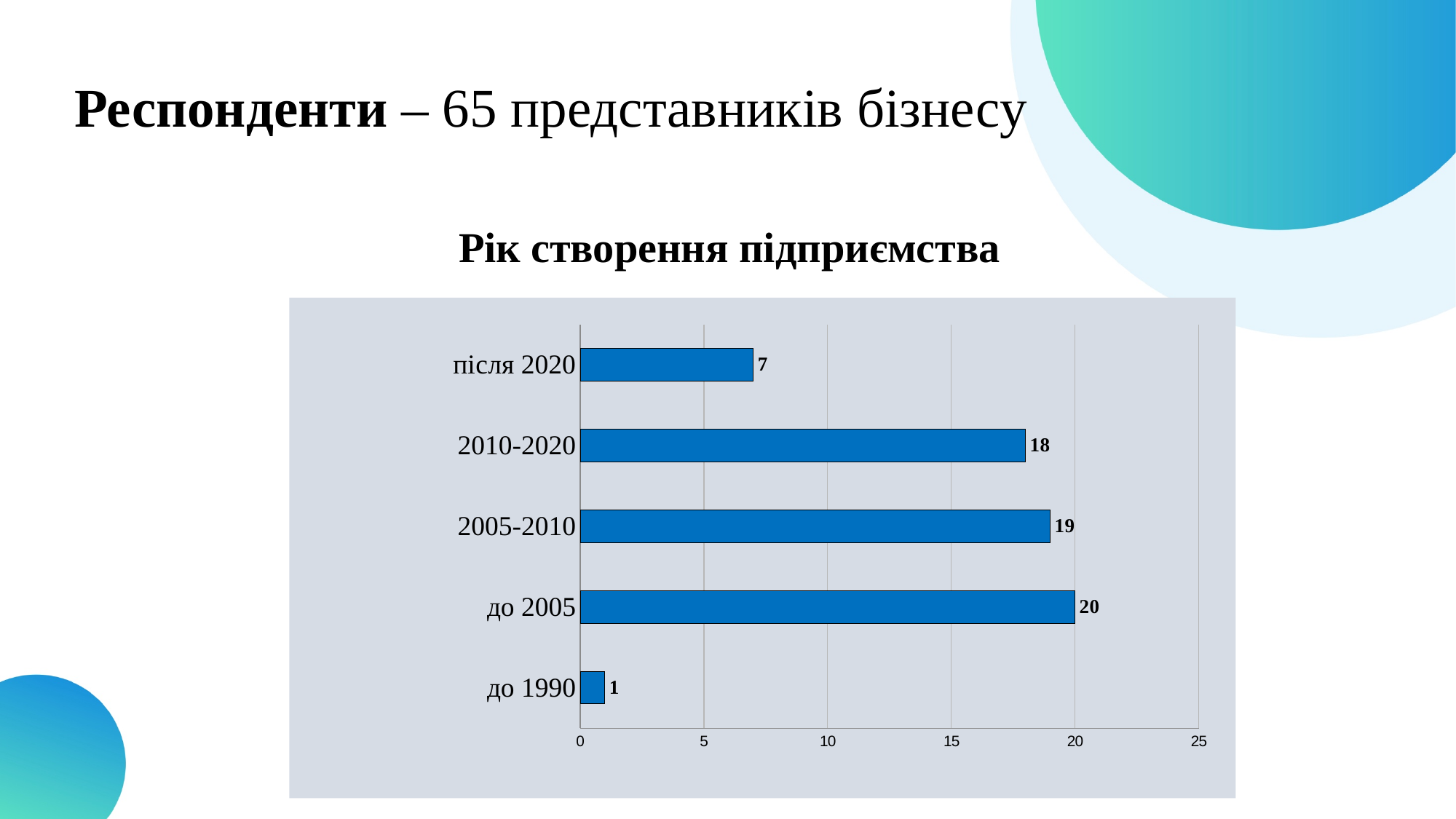
Is the value for "2010-2020" greater or less than 15? greater What is the maximum value shown on the horizontal axis? 25 What is the value for the category "після 2020"? 7 What kind of chart is shown on the slide? bar chart What is the title of the chart? Рік створення підприємства What is the value for the category "до 2005"? 20 How many categories are shown in the chart? 5 What is the value for the category "2010-2020"? 18 What is the difference between the values for "2005-2010" and "після 2020"? 12 Which category has the highest value? до 2005 Which category has the lowest value? до 1990 Which is larger, the value for "2005-2010" or the value for "2010-2020"? 2005-2010